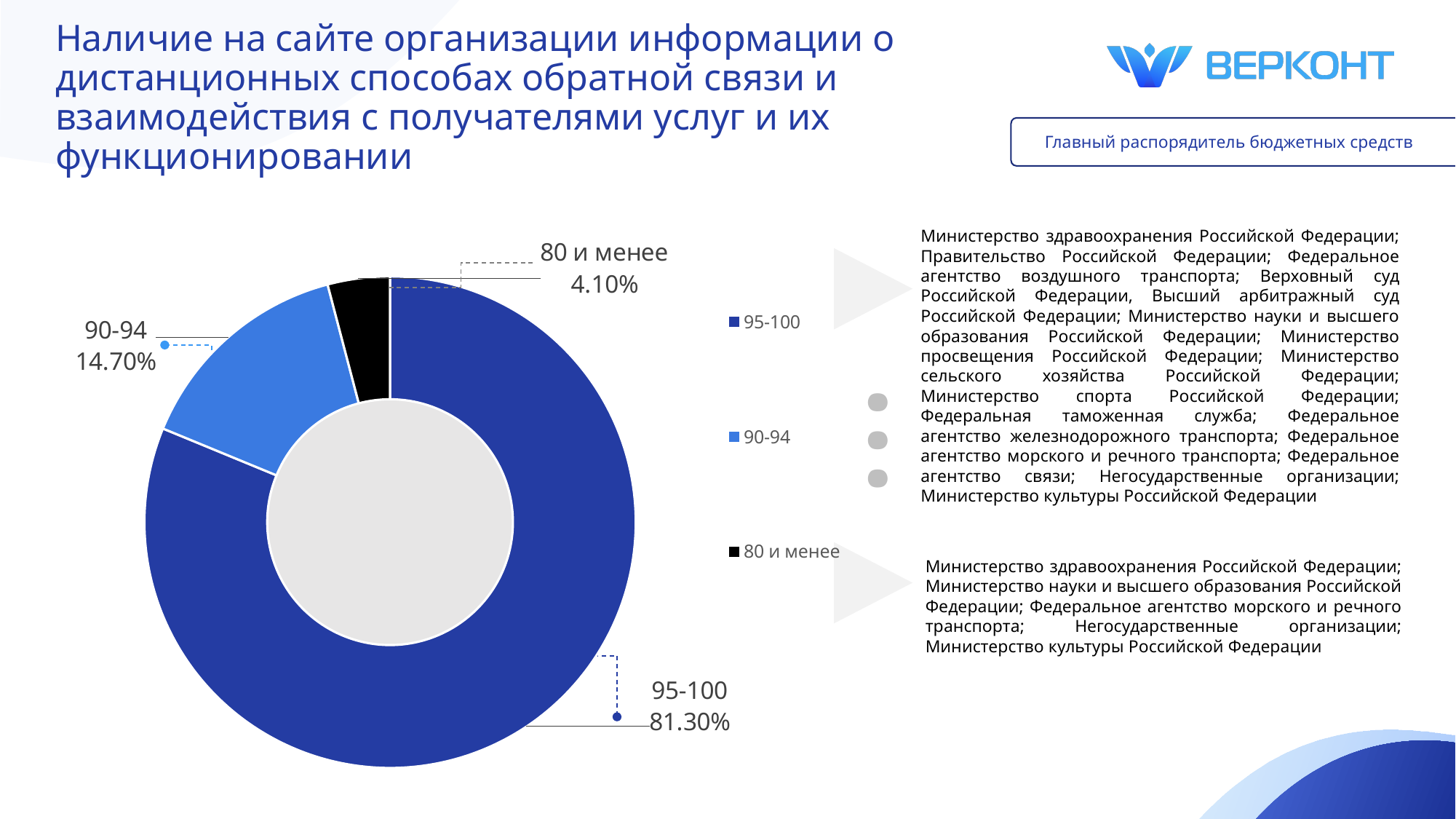
What is the value shown for the 90-94 category? 14.70% How many entries does the chart legend list? 3 What kind of chart is shown on the slide? Pie chart (doughnut) What is the difference between the shares of the 90-94 and '80 и менее' categories? 10.60% What share of the pie chart does the 95-100 category hold? 81.30% Which category has the largest share of the pie chart? 95-100 Which is larger: the share for 90-94 or the share for '80 и менее'? 90-94 How many categories does the pie chart show? 3 What is the value shown for the '80 и менее' category? 4.10% What colour is the slice for the '80 и менее' category? Black Which category has the smallest share of the pie chart? 80 и менее What is the difference between the shares of the 95-100 and 90-94 categories? 66.60%